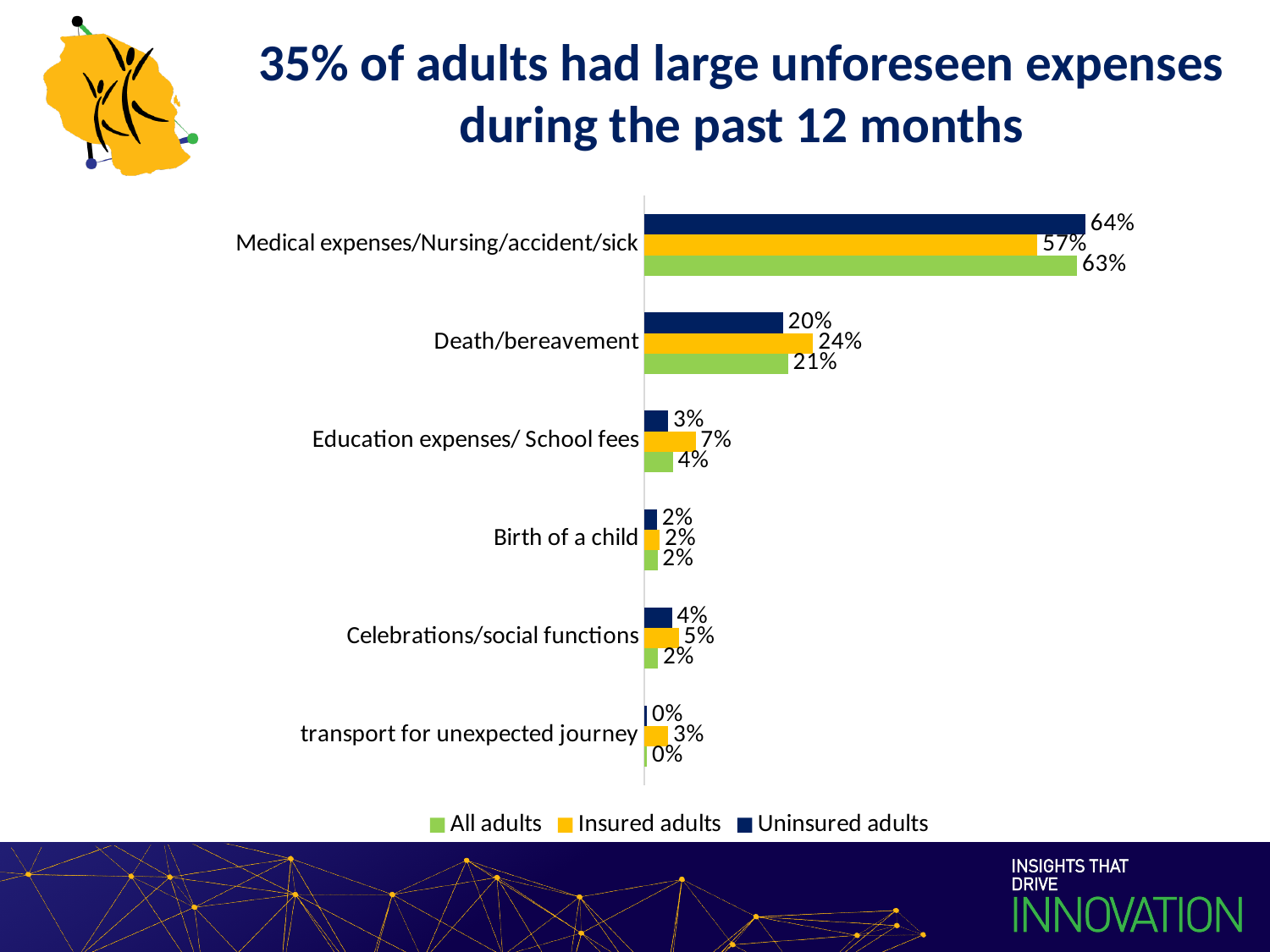
How many categories are shown on the chart? 6 Which colour represents Insured adults in the chart? Yellow Which category has the highest value for All adults? Medical expenses/Nursing/accident/sick For Death/bereavement, which is larger: the Insured adults value or the Uninsured adults value? Insured adults What is the value for All adults for Education expenses/ School fees? 4% What is the value for Insured adults for transport for unexpected journey? 3% What is the value for Insured adults for Death/bereavement? 24% What kind of chart is shown on the slide? Bar chart What is the value for Uninsured adults for Medical expenses/Nursing/accident/sick? 64% Which category has the lowest value for Uninsured adults? transport for unexpected journey What is the difference between the Uninsured adults and Insured adults values for Medical expenses/Nursing/accident/sick? 7% How many series does the legend list? 3